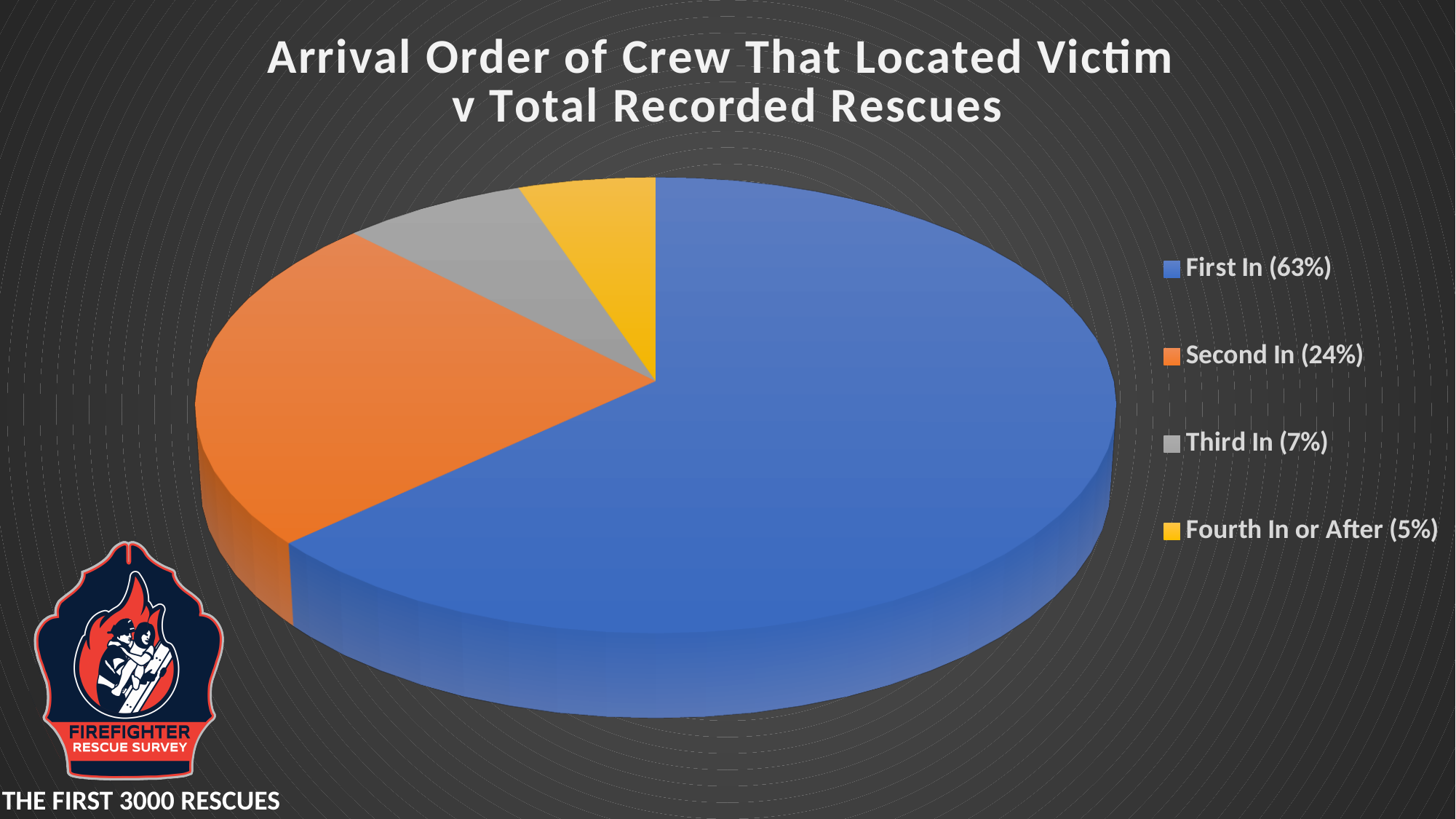
Which is larger, the share for Third In or the share for Fourth In or After? Third In What share of the pie does First In represent? 63% What is the difference in percentage points between First In and Second In? 39 What is the title of the chart? Arrival Order of Crew That Located Victim v Total Recorded Rescues What colour is the slice for Second In? Orange What share of the pie does Second In represent? 24% What kind of chart is shown on the slide? Pie chart What share of the pie does Fourth In or After represent? 5% How many categories does the pie chart show? 4 Which category has the largest share of the pie? First In Which category has the smallest share of the pie? Fourth In or After